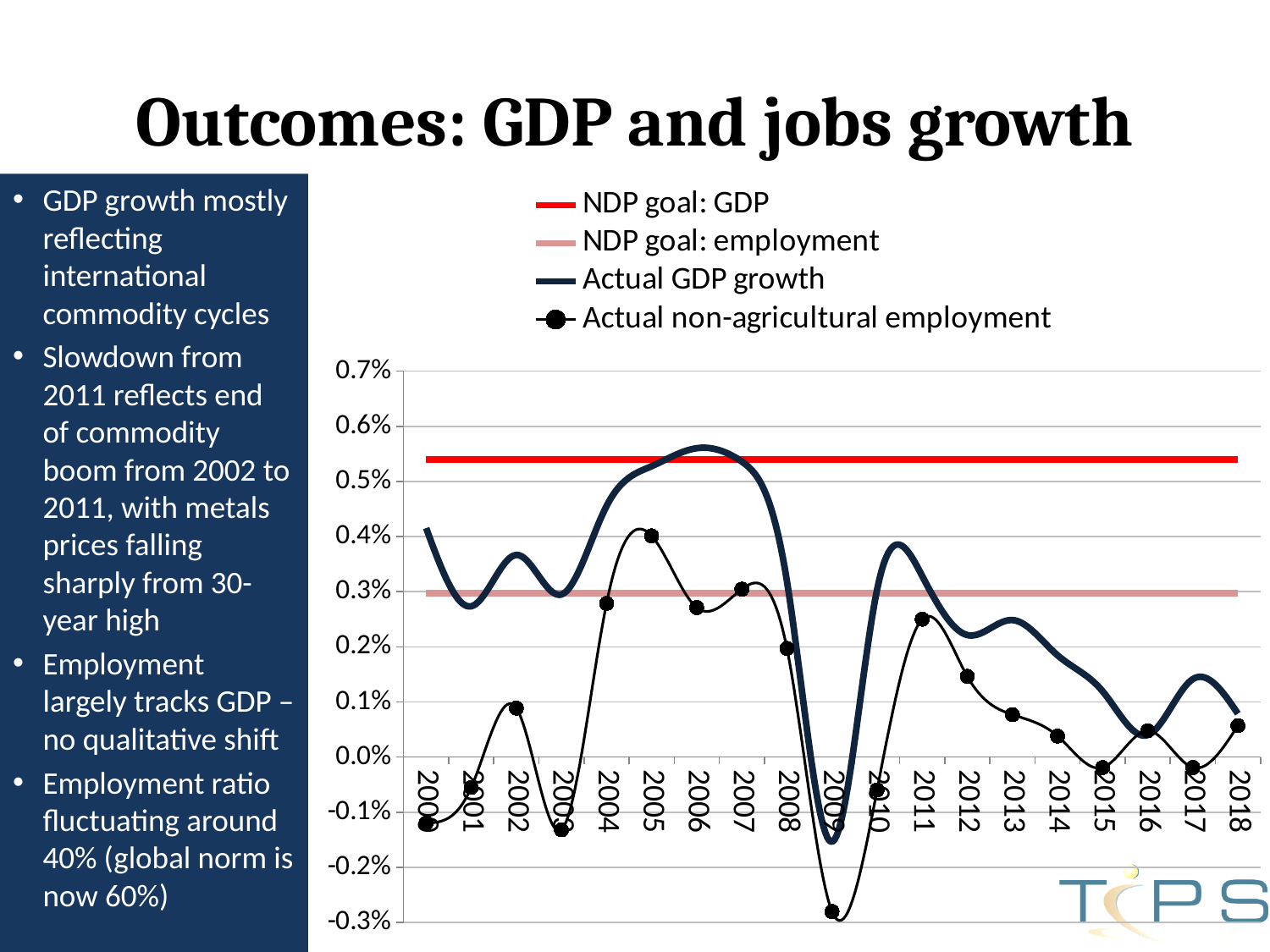
Which is larger: Actual GDP growth in 2006 or Actual GDP growth in 2016? 2006 Is the NDP goal: GDP line greater or less than 0.5%? greater Does Actual GDP growth rise or fall from 2011 to 2016? fall In which year does Actual non-agricultural employment reach its highest value? 2005 How many years are shown along the x axis? 19 In which year does Actual non-agricultural employment reach its lowest value? 2009 What kind of chart is shown on the slide? line chart In which year does Actual GDP growth reach its highest value? 2006 Is the value for Actual non-agricultural employment in 2009 greater or less than -0.2%? less How many series does the legend list? 4 Which series is drawn with circular markers? Actual non-agricultural employment Is the value for Actual GDP growth in 2006 greater or less than 0.5%? greater